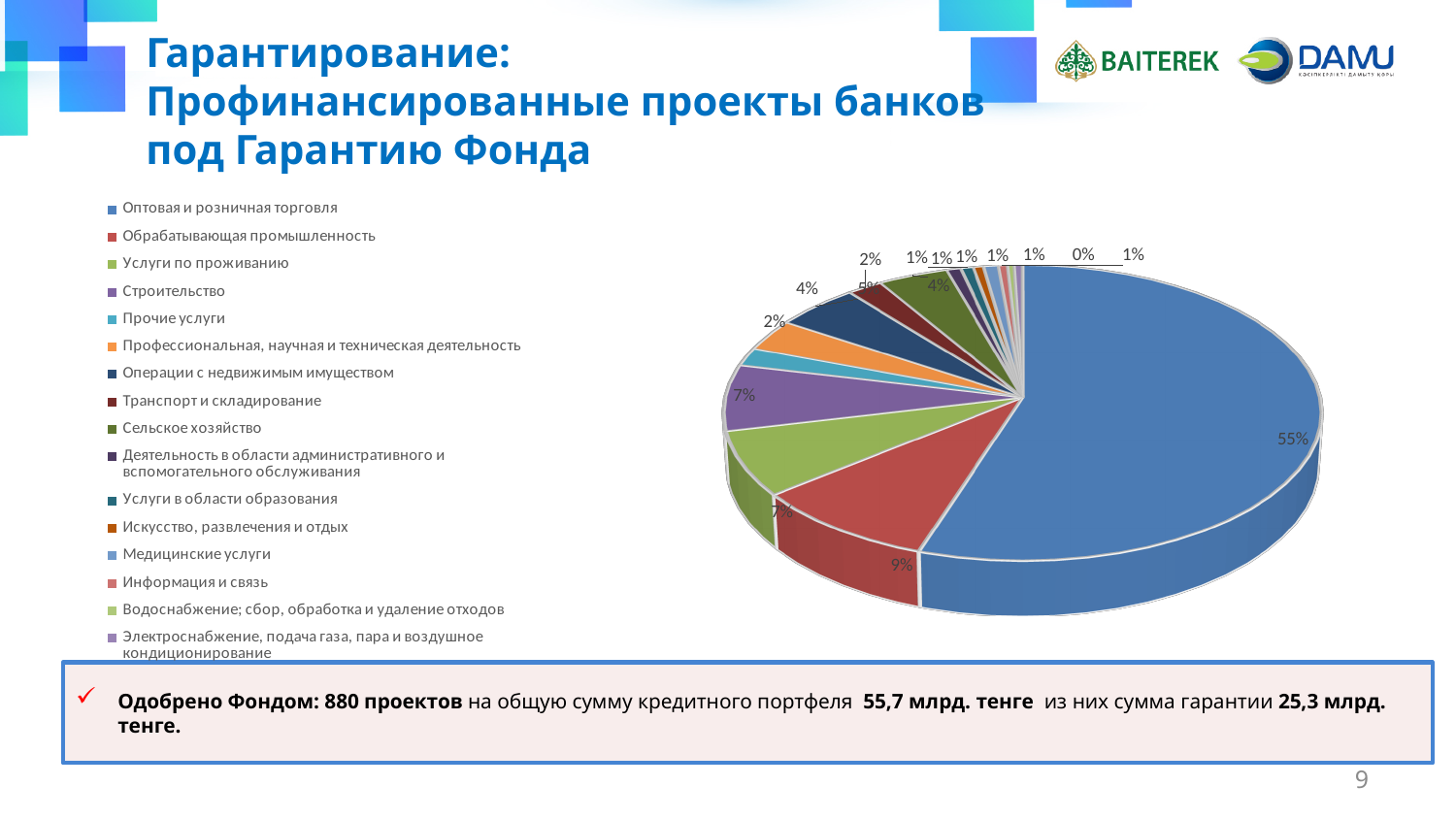
What is the value shown for Услуги по проживанию? 7% Which category has the largest share of the pie? Оптовая и розничная торговля What is the value shown for Обрабатывающая промышленность? 9% Which is larger, the share of Обрабатывающая промышленность or the share of Строительство? Обрабатывающая промышленность What share of the pie does Оптовая и розничная торговля have? 55% How many categories does the legend list? 16 What kind of chart is shown on the slide? pie chart What is the value shown for Строительство? 7% What is the difference between the shares of Оптовая и розничная торговля and Обрабатывающая промышленность? 46 percentage points What is the title of the slide containing the chart? Гарантирование: Профинансированные проекты банков под Гарантию Фонда What is the smallest percentage value labelled on the pie? 0% Is the share of Оптовая и розничная торговля greater or less than 50%? greater